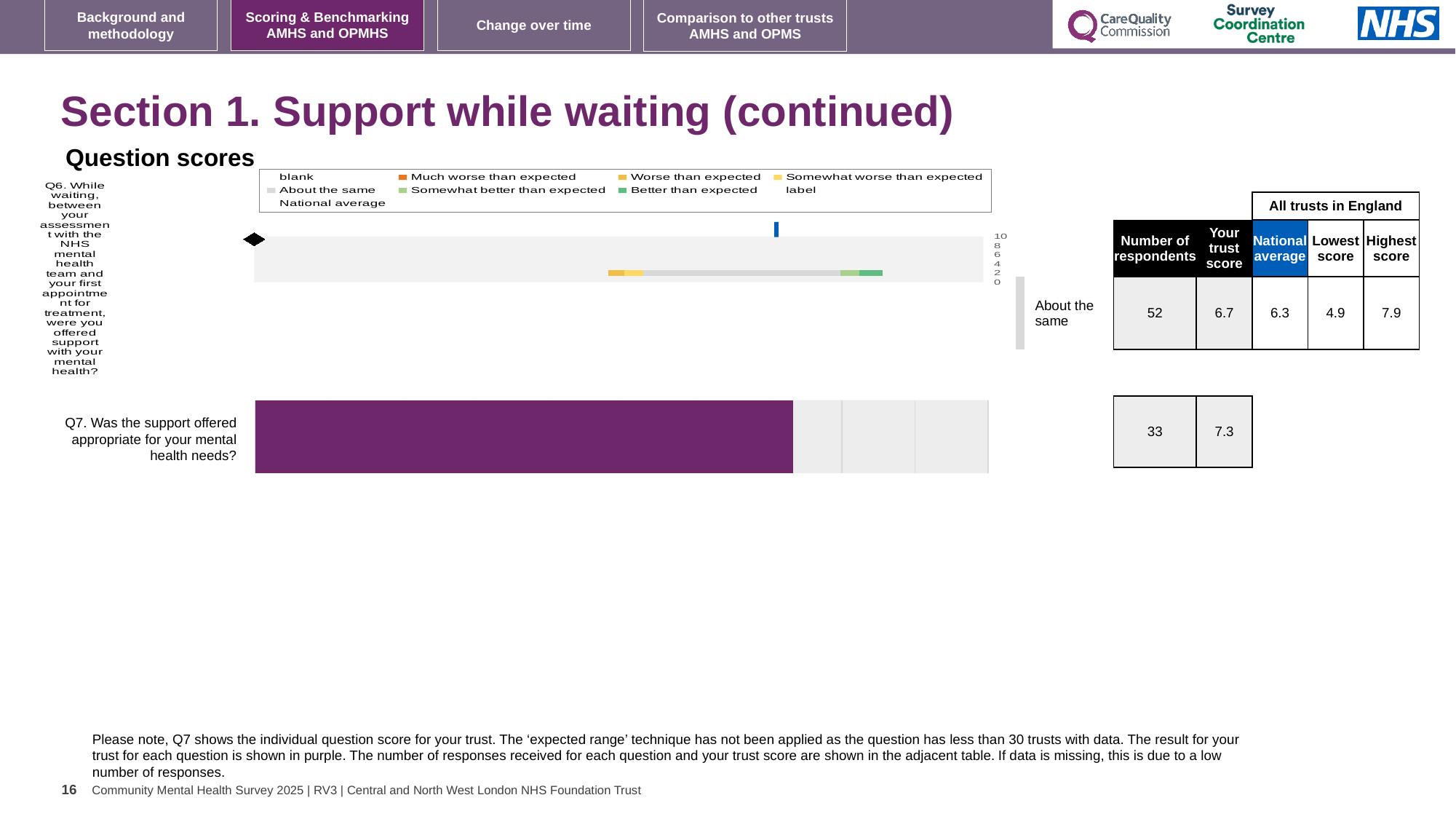
For Q6, what is the trust's score shown in the table? 6.7 What kind of chart is used to show the Q7 score on the slide? bar chart What colour is the bar showing the trust's Q7 score? purple What is the trust's score for Q7? 7.3 For Q6, what is the national average score? 6.3 How many entries does the legend above the Q6 chart list? 9 For Q6, which is larger: the trust's score or the national average? the trust's score For Q6, what is the difference between the highest and lowest scores among all trusts in England? 3.0 How many respondents answered Q7? 33 For Q6, what is the lowest score among all trusts in England? 4.9 How many more respondents answered Q6 than Q7? 19 For Q6, what is the highest score among all trusts in England? 7.9